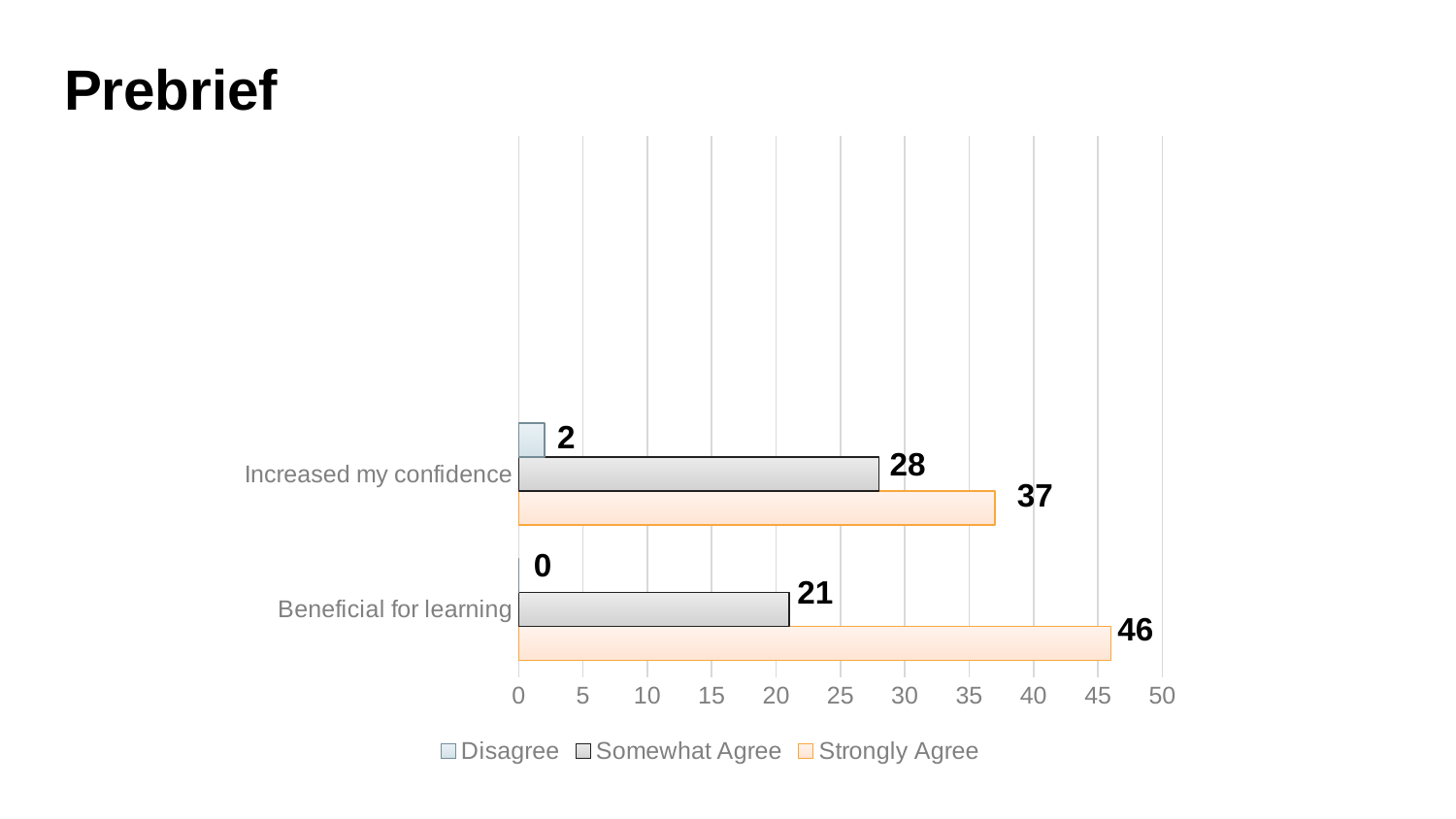
What is the title of the slide? Prebrief Which category has the lowest Somewhat Agree value? Beneficial for learning What is the Strongly Agree value for Beneficial for learning? 46 Which category has the highest Strongly Agree value? Beneficial for learning What is the Somewhat Agree value for Increased my confidence? 28 What is the difference between the Strongly Agree values for Beneficial for learning and Increased my confidence? 9 What is the Disagree value for Beneficial for learning? 0 Which is larger: the Somewhat Agree value for Increased my confidence or the Somewhat Agree value for Beneficial for learning? Increased my confidence What kind of chart is shown on the slide? Bar chart How many categories are shown on the y axis? 2 What is the Disagree value for Increased my confidence? 2 How many series does the legend list? 3